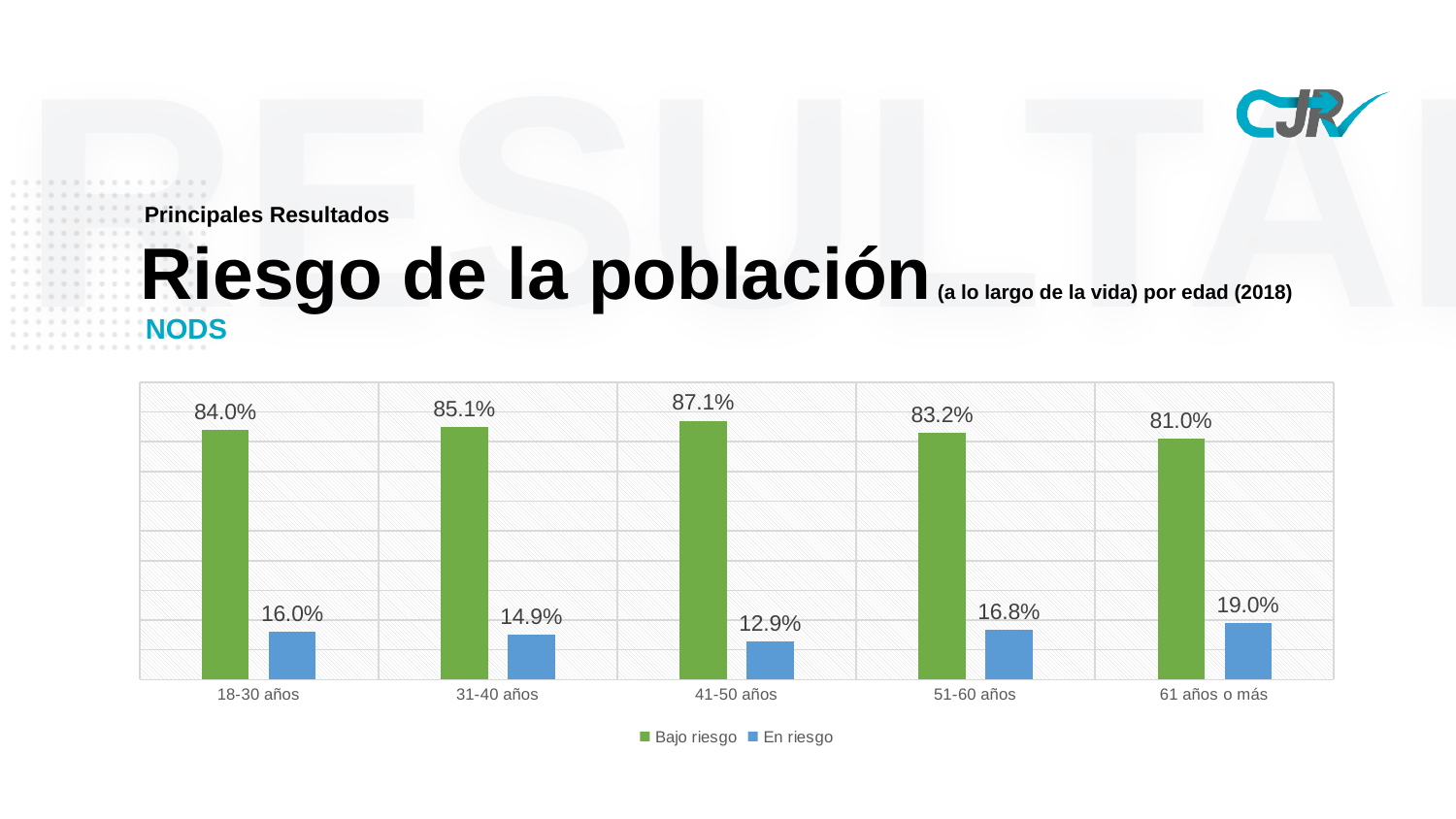
What is the difference between the Bajo riesgo and En riesgo values for 51-60 años? 66.4% Which series is shown in green in the legend? Bajo riesgo How many series does the legend list? 2 What is the value for Bajo riesgo in the 41-50 años category? 87.1% What is the value for En riesgo in the 61 años o más category? 19.0% What is the value for En riesgo in the 18-30 años category? 16.0% How many age categories are shown on the x axis? 5 Which age category has the lowest En riesgo value? 41-50 años Which age category has the lowest Bajo riesgo value? 61 años o más Which is larger: the En riesgo value for 31-40 años or for 51-60 años? 51-60 años What kind of chart is shown on the slide? Bar chart Which age category has the highest Bajo riesgo value? 41-50 años